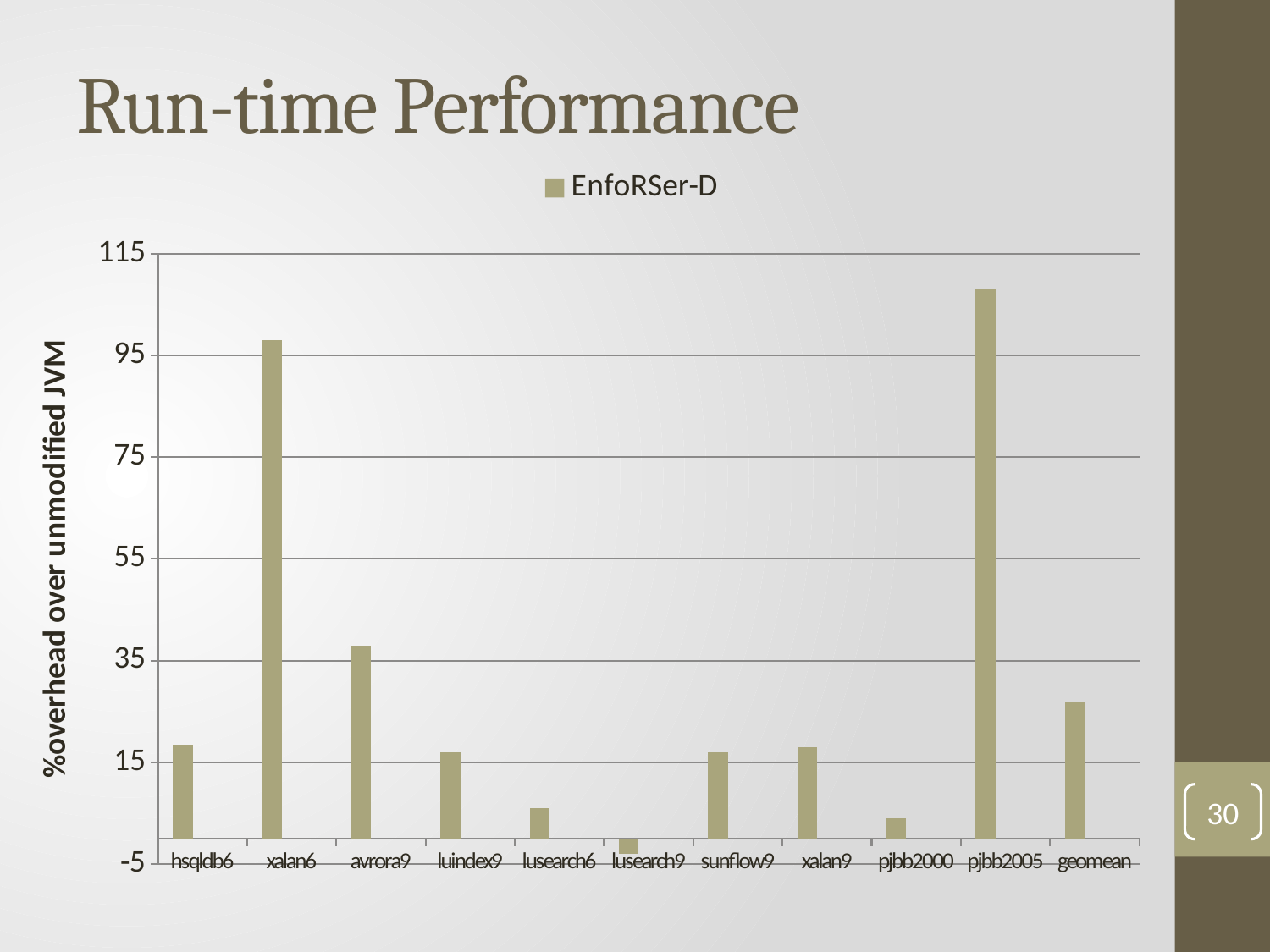
Is the value for xalan6 greater or less than 95? greater How many benchmark categories are plotted on the x axis? 11 Which category has the highest overhead? pjbb2005 What is the name of the series shown in the legend? EnfoRSer-D Is the value for avrora9 greater or less than 35? greater Which has a larger overhead, xalan6 or avrora9? xalan6 What kind of chart is shown on the slide? bar chart Which has a larger overhead, pjbb2005 or xalan6? pjbb2005 What is the label of the y axis? %overhead over unmodified JVM How many series does the legend list? 1 Is the value for geomean greater or less than 35? less Which category has the lowest overhead? lusearch9